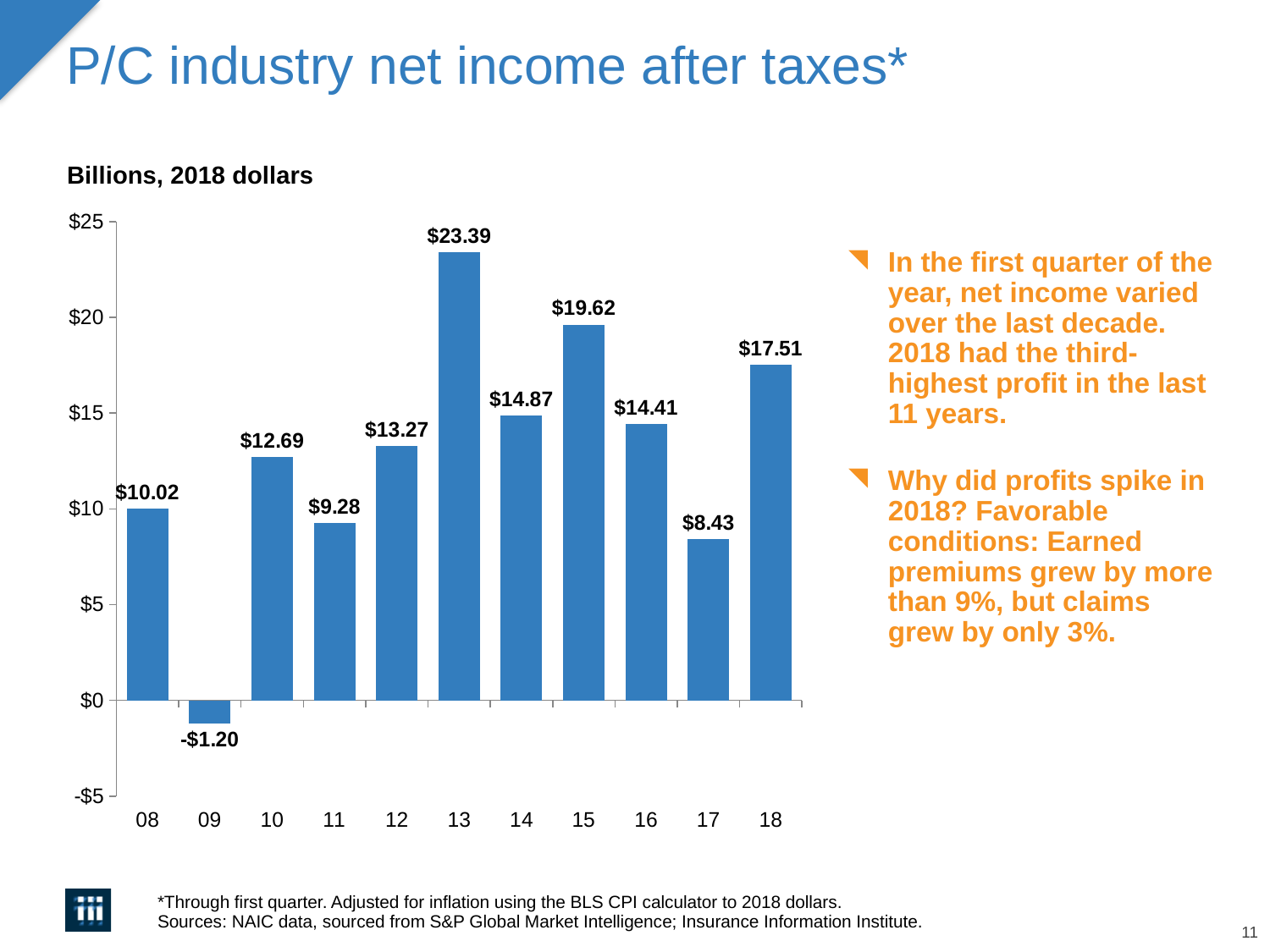
Which year has a larger net income, 14 or 16? 14 Which year has the lowest net income after taxes? 09 What is the net income after taxes for 13? $23.39 Is the value for 11 greater or less than $10? less What kind of chart is shown on the slide? bar chart What is the difference between the net income for 18 and for 17? $9.08 How many years are shown on the x axis? 11 What is the net income after taxes for 09? -$1.20 What unit is stated above the chart? Billions, 2018 dollars What is the net income after taxes for 18? $17.51 What is the difference between the net income for 13 and for 15? $3.77 Which year has the highest net income after taxes? 13